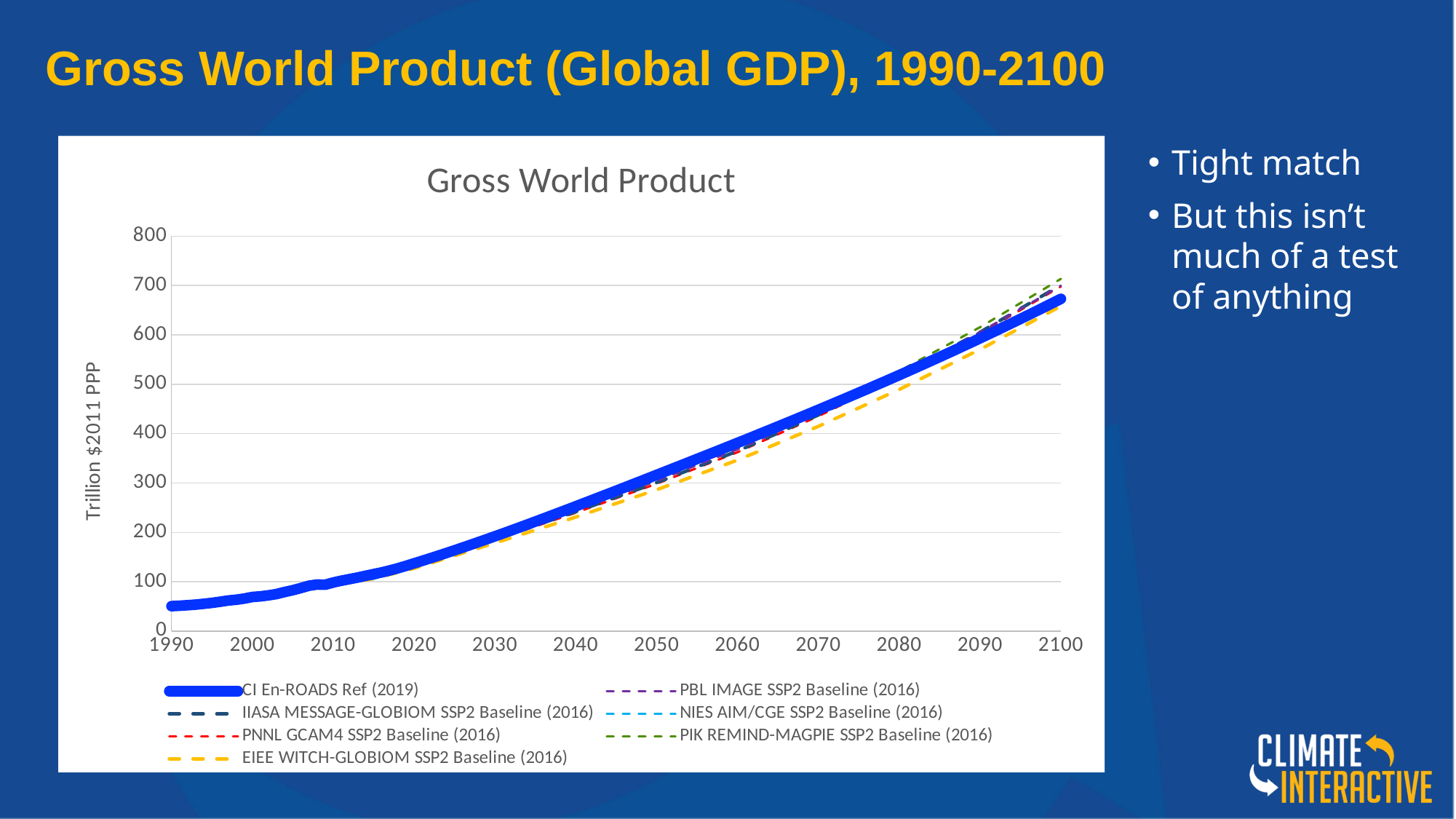
How many series does the legend of the Gross World Product chart list? 7 Is the value of CI En-ROADS Ref (2019) in 2100 greater or less than 600? greater Is the value of CI En-ROADS Ref (2019) in 2050 greater or less than 400? less Is the value of CI En-ROADS Ref (2019) in 1990 greater or less than 100? less In 2100, which is larger: PIK REMIND-MAGPIE SSP2 Baseline (2016) or EIEE WITCH-GLOBIOM SSP2 Baseline (2016)? PIK REMIND-MAGPIE SSP2 Baseline (2016) Do the values in the Gross World Product chart rise or fall from 1990 to 2100? Rise What type of chart is shown on the slide? Line chart Which series has the lowest value in 2100? EIEE WITCH-GLOBIOM SSP2 Baseline (2016) What is the title of the chart? Gross World Product What is the label on the vertical axis of the chart? Trillion $2011 PPP Which series has the highest value in 2100? PIK REMIND-MAGPIE SSP2 Baseline (2016)